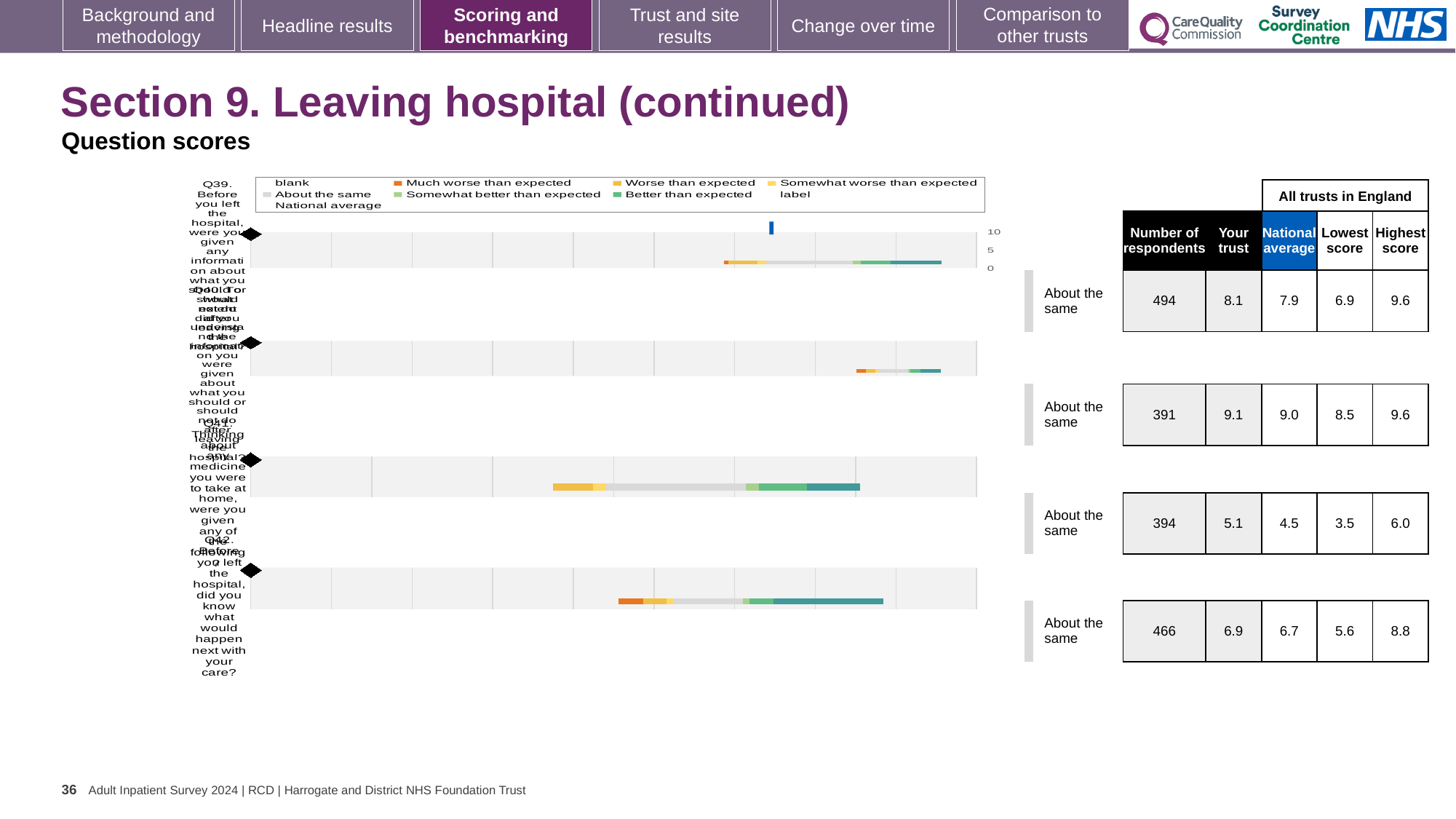
In the table next to the charts, what is the national average for the first (top) question, Q39? 7.9 In the table next to the charts, what is the 'Your trust' score for the first (top) question, Q39? 8.1 What benchmark category is shown beside each of the four charts? About the same In the table next to the charts, what is the difference between the 'Your trust' score and the national average for the third question? 0.6 In the table next to the charts, which of the four questions has the highest 'Your trust' score? the second question (9.1) How many question score charts are shown on the slide? 4 In the table next to the charts, is the 'Your trust' score for the top question (Q39) larger or smaller than the national average? larger In the table next to the charts, how many respondents answered the top question, Q39? 494 In the table next to the charts, what is the 'Your trust' score for the bottom question, Q42? 6.9 What kind of chart is used for the question score charts on this slide? bar chart In the table next to the charts, which of the four questions has the lowest 'Your trust' score? the third question (5.1) In the table next to the charts, what is the highest score in England for the bottom question, Q42? 8.8